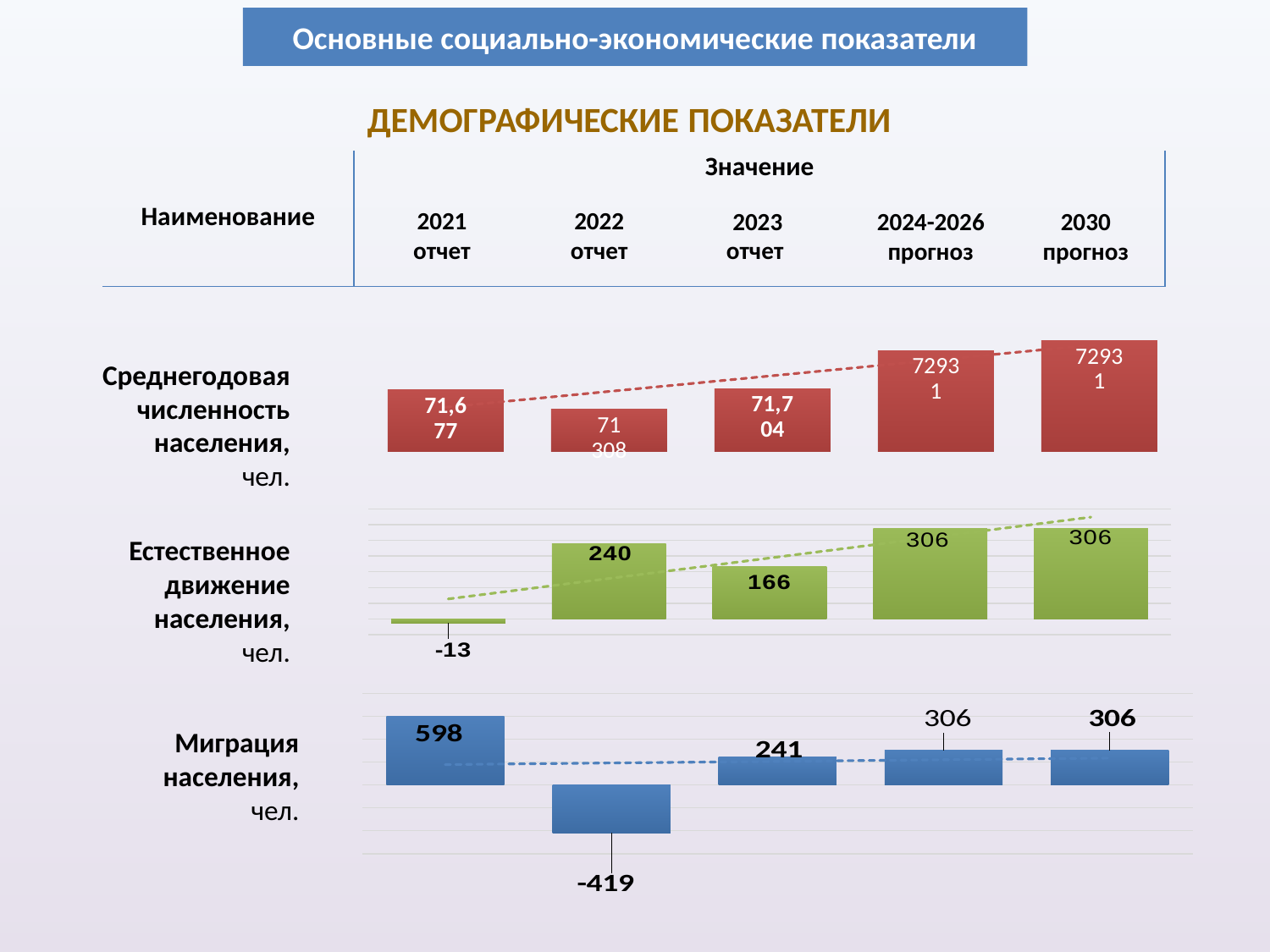
In the 'Миграция населения' chart, which period has the highest value? 2021 отчет In the 'Естественное движение населения' chart, which is larger, the value for 2022 or for 2023? 2022 In the 'Миграция населения' chart, which period has the lowest value? 2022 отчет In the 'Миграция населения' chart, what is the difference between the 2021 and 2023 values? 357 How many periods are plotted in the 'Миграция населения' chart? 5 In the 'Миграция населения' chart, what is the value for 2022 отчет? -419 In the 'Естественное движение населения' chart, what is the difference between the 2022 and 2023 values? 74 In the 'Естественное движение населения' chart, what is the value for 2022 отчет? 240 In the 'Естественное движение населения' chart, what is the value for 2021 отчет? -13 In the 'Среднегодовая численность населения' chart, which period has the lowest value? 2022 отчет In the 'Миграция населения' chart, what is the value for 2023 отчет? 241 In the 'Естественное движение населения' chart, which period has the lowest value? 2021 отчет